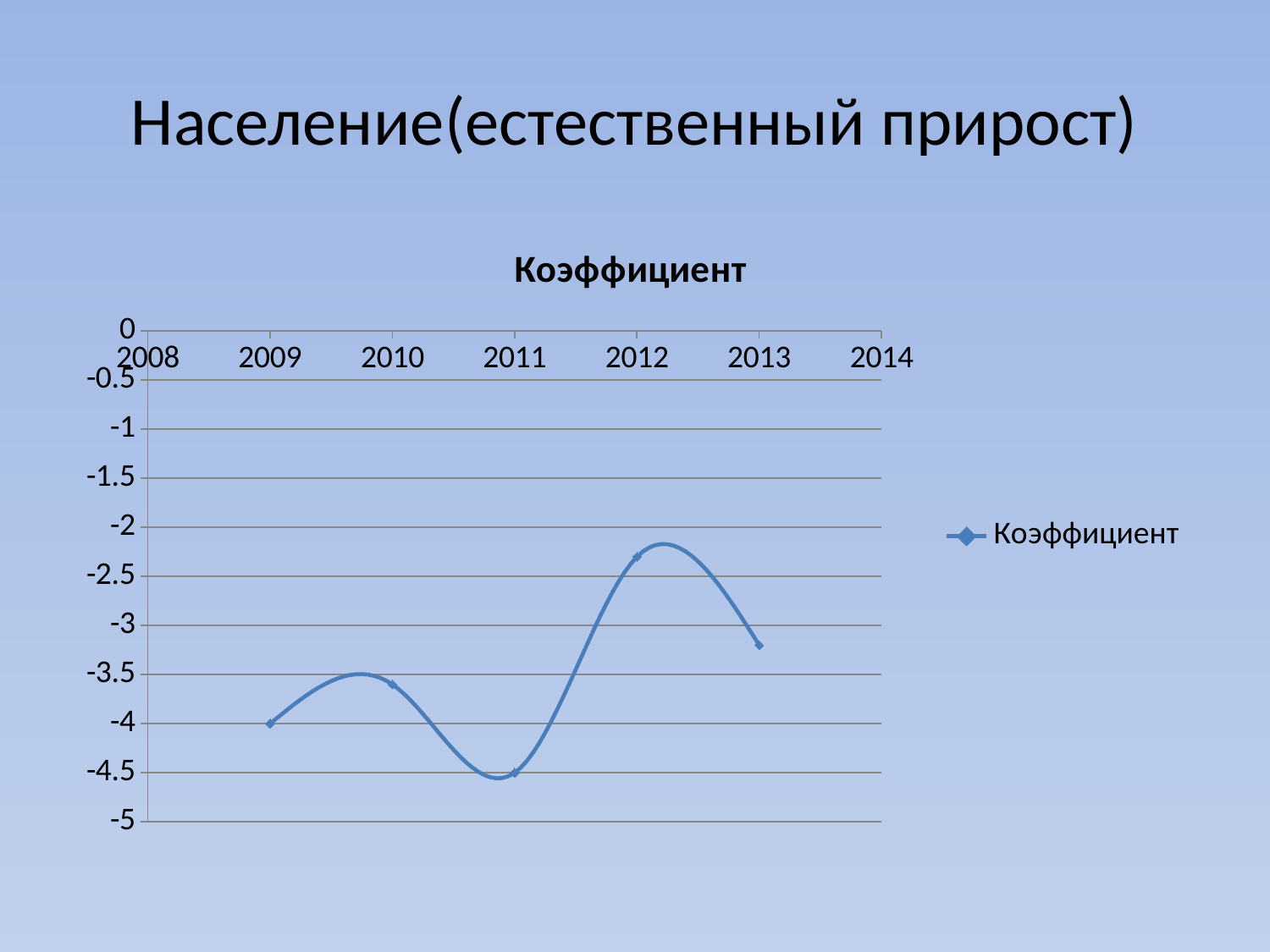
What is the difference between the values for 2009 and 2011? 0.5 What is the title of the chart? Коэффициент Which year has the lowest value of Коэффициент? 2011 What kind of chart is shown on the slide? line chart Is the value for 2012 greater or less than -3? greater Which is larger, the value for 2012 or the value for 2013? 2012 How many data points are plotted on the line? 5 What is the value of Коэффициент for 2009? -4 How many series does the legend list? 1 What is the value of Коэффициент for 2011? -4.5 Which year has the highest value of Коэффициент? 2012 Is the value for 2013 greater or less than -3.5? greater